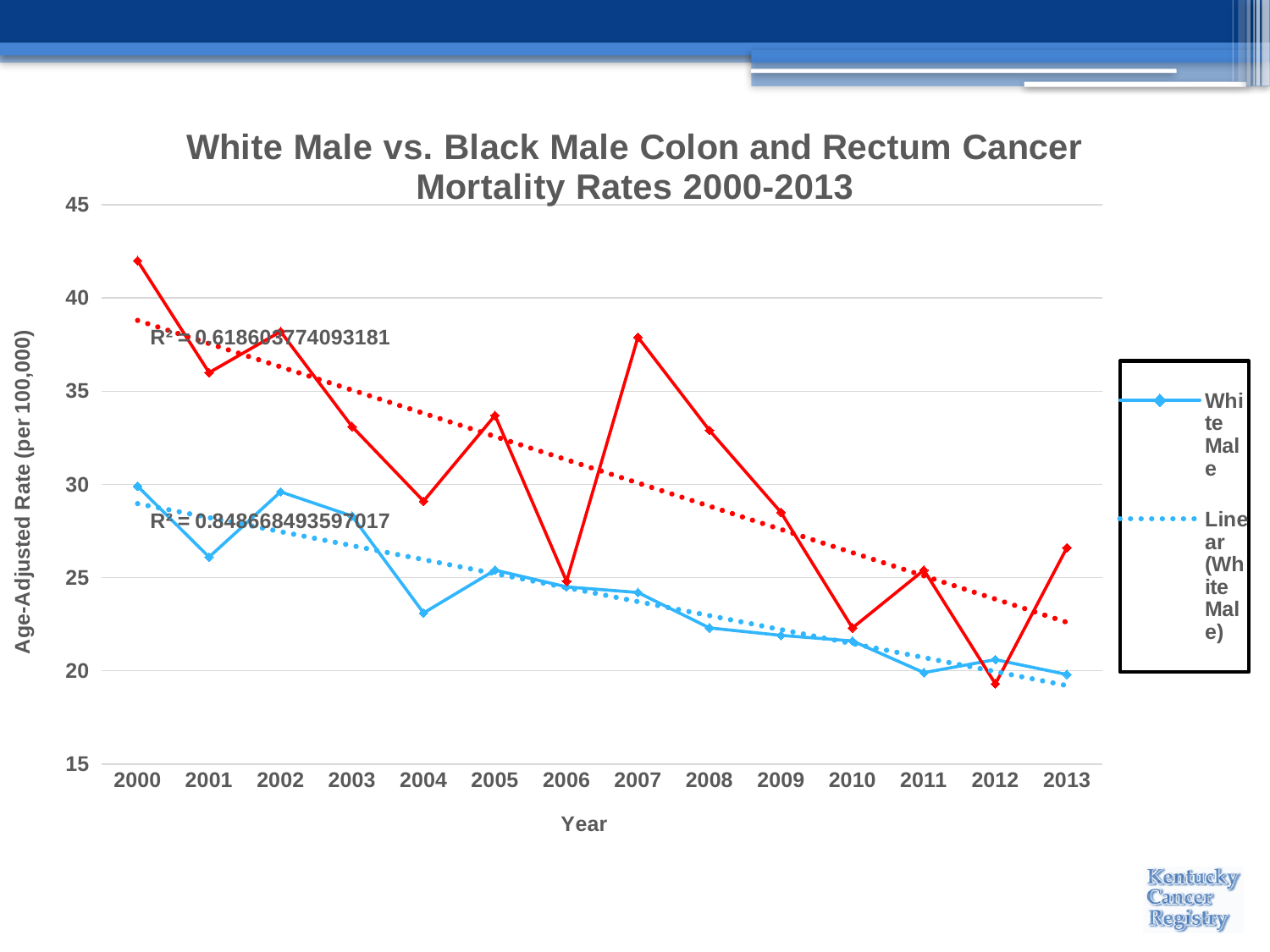
In 2007, which line has the higher value, the red (Black Male) line or the blue White Male line? The red (Black Male) line Is the White Male value for 2004 greater or less than 25? less What is the title of the chart? White Male vs. Black Male Colon and Rectum Cancer Mortality Rates 2000-2013 In which year does the red (Black Male) line reach its highest value? 2000 What kind of chart is shown on the slide? Line chart What is the label of the y axis? Age-Adjusted Rate (per 100,000) How many years are shown along the x axis of the chart? 14 Is the White Male value for 2000 greater or less than 25? greater Overall, do the White Male values rise or fall from 2000 to 2013? Fall Is the value of the red (Black Male) line for 2007 greater or less than 35? greater